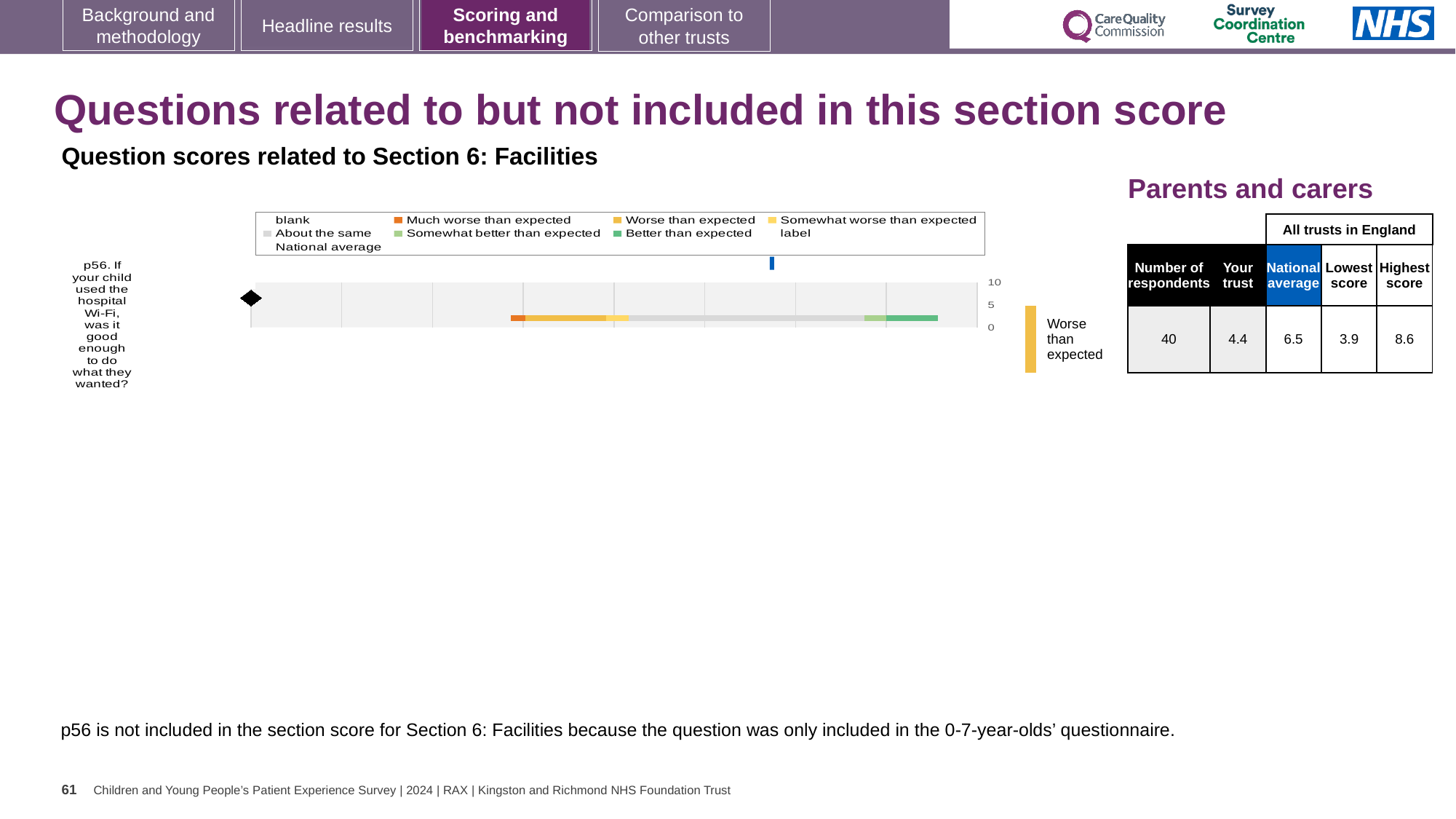
What is the lowest score among all trusts in England for p56? 3.9 What is the national average score for p56? 6.5 What is the difference between the highest and lowest scores for p56? 4.7 How many respondents answered p56? 40 Which benchmark category is the trust's p56 result labelled as? Worse than expected How many questions are plotted in the chart? 1 Which colour in the legend represents 'Much worse than expected'? Orange What is the trust's score for p56 (hospital Wi-Fi good enough)? 4.4 What is the highest score among all trusts in England for p56? 8.6 Which is larger for p56: the trust's score or the national average? National average By how much does the national average exceed the trust's score for p56? 2.1 What kind of chart is used to show the p56 question score? bar chart